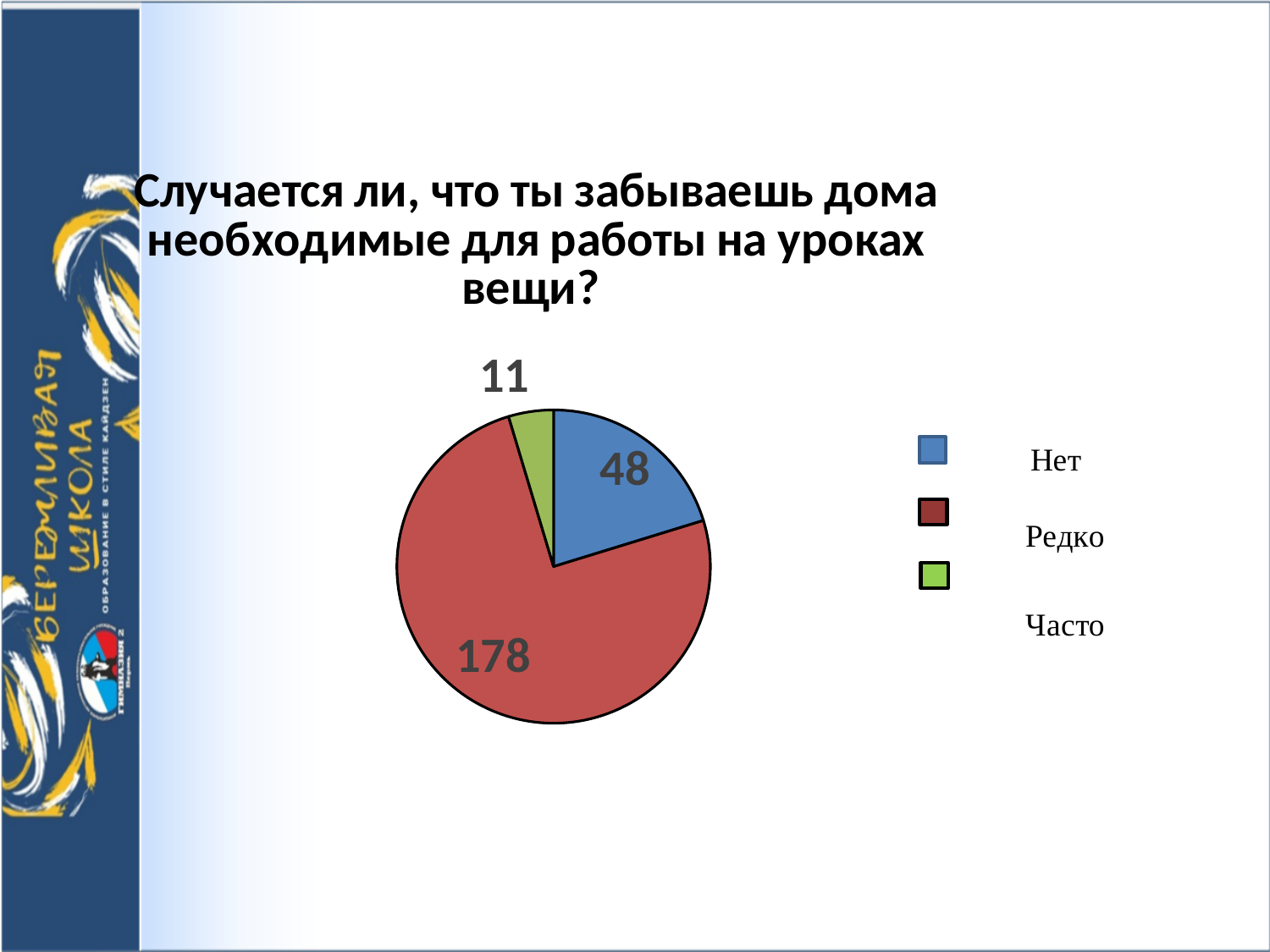
What is the difference between the values for "Редко" and "Нет"? 130 What is the difference between the values for "Нет" and "Часто"? 37 What is the value for the "Нет" slice of the pie chart? 48 Which colour represents "Часто" in the pie chart? Green What is the value for the "Редко" slice of the pie chart? 178 What is the total of all the values shown in the pie chart? 237 Which category has the largest slice in the pie chart? Редко How many slices does the pie chart have? 3 Which is larger, the value for "Нет" or the value for "Часто"? Нет What is the value for the "Часто" slice of the pie chart? 11 Which category has the smallest slice in the pie chart? Часто What kind of chart is shown on the slide? Pie chart